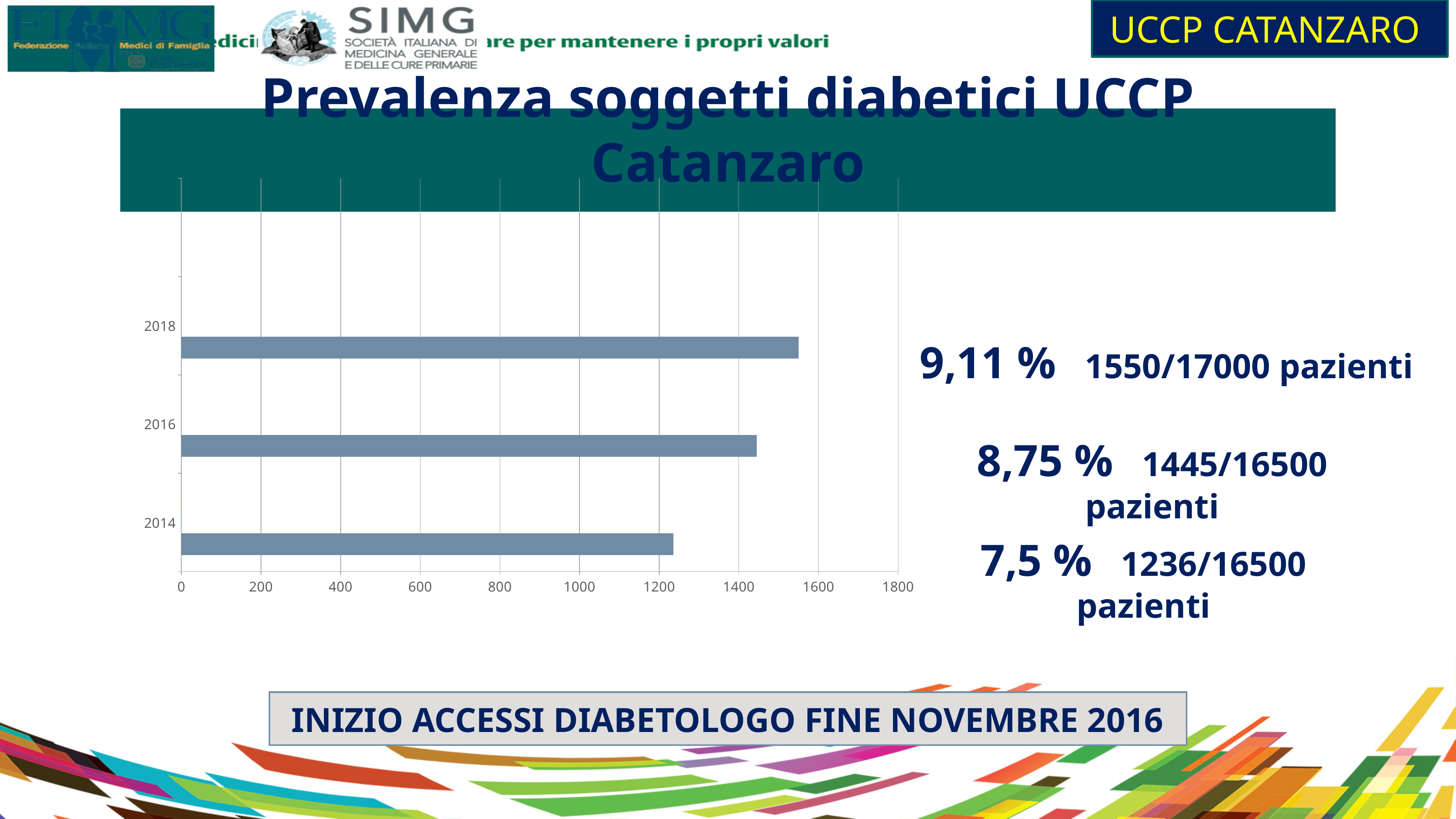
Is the value for 2014 greater or less than 1400? less Do the bar values rise or fall from 2014 to 2018? rise Is the value for 2018 greater or less than 1400? greater What is the title of the chart? Prevalenza soggetti diabetici UCCP Catanzaro What kind of chart is shown on the slide? bar chart Which year has the shortest bar in the chart? 2014 According to the annotation next to the 2018 bar, how many diabetic patients were there in 2018? 1550 Which bar is longer, 2016 or 2018? 2018 What prevalence percentage is shown next to the 2014 bar? 7,5 % Which year has the longest bar in the chart? 2018 How many years (bars) are plotted in the chart? 3 Is the value for 2016 greater or less than 1200? greater